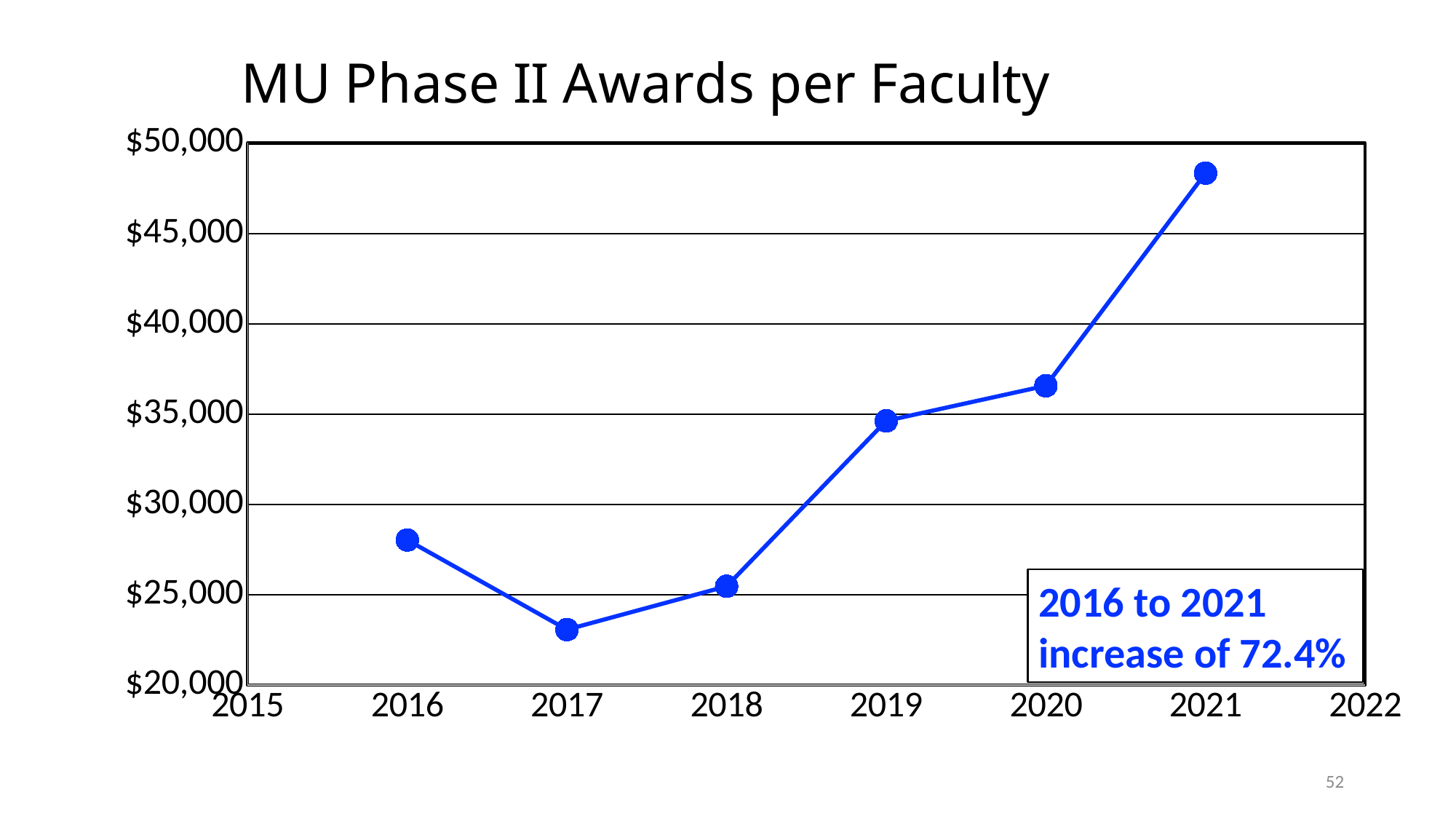
What is the title of the chart? MU Phase II Awards per Faculty Is the value for 2020 greater or less than $35,000? greater Is the value for 2017 greater or less than $25,000? less Which year has the larger value, 2019 or 2018? 2019 According to the text box on the chart, what is the percentage increase from 2016 to 2021? 72.4% How many data points are plotted on the chart? 6 Is the value for 2021 greater or less than $45,000? greater Which year has the lowest awards per faculty? 2017 Do the values rise or fall from 2017 to 2021? rise Which year has the highest awards per faculty? 2021 What type of chart is shown on the slide? line chart